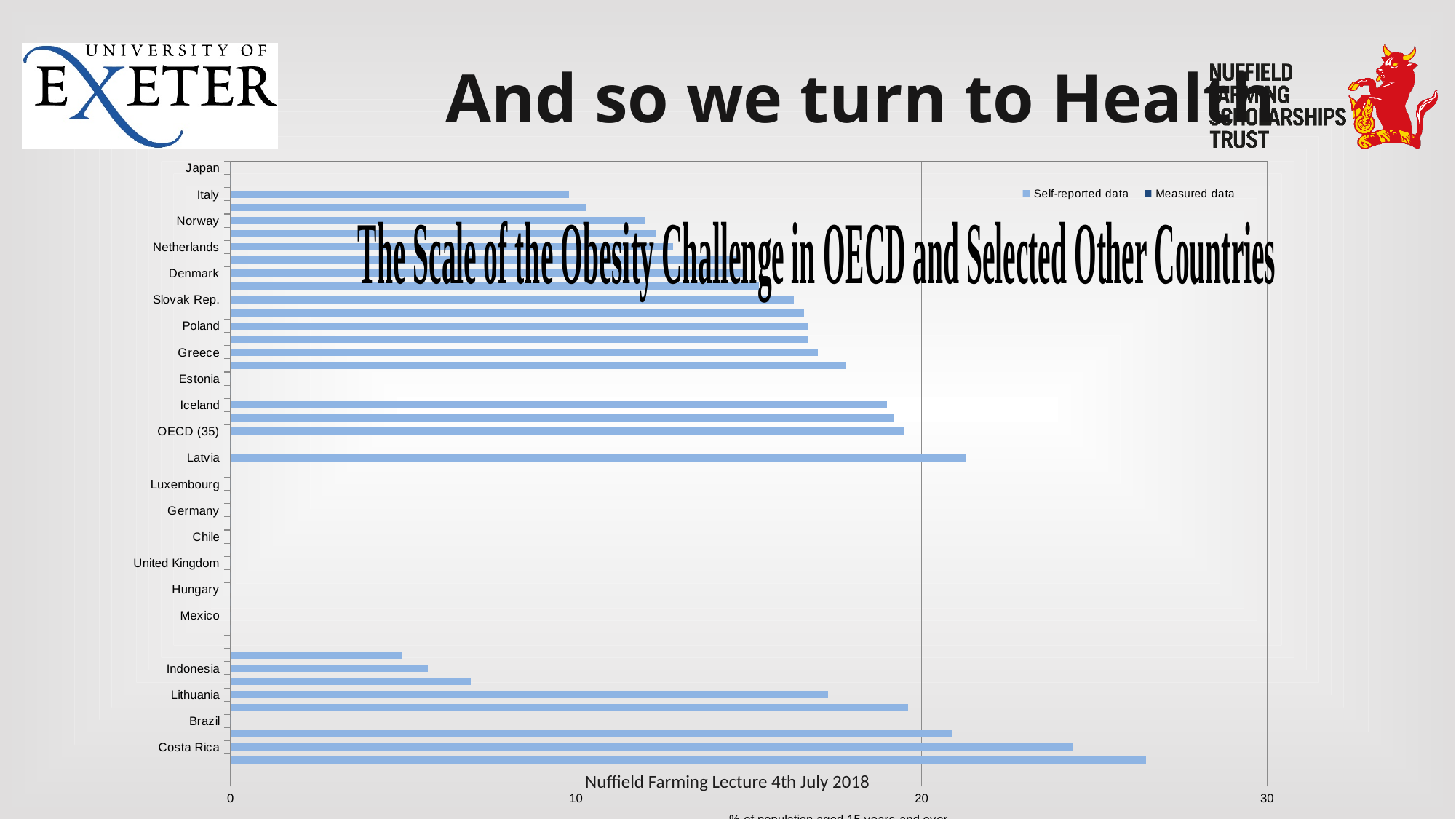
Is the value for Lithuania greater or less than 20? less How many series does the chart's legend list? 2 What are the two series named in the chart's legend? Self-reported data and Measured data What is the title printed across the chart? The Scale of the Obesity Challenge in OECD and Selected Other Countries Is the value for Costa Rica greater or less than 20? greater Which has the larger value, Latvia or Indonesia? Latvia Is the value for Latvia greater or less than 20? greater What kind of chart is shown on the slide? Bar chart Which has the larger value, Costa Rica or Italy? Costa Rica